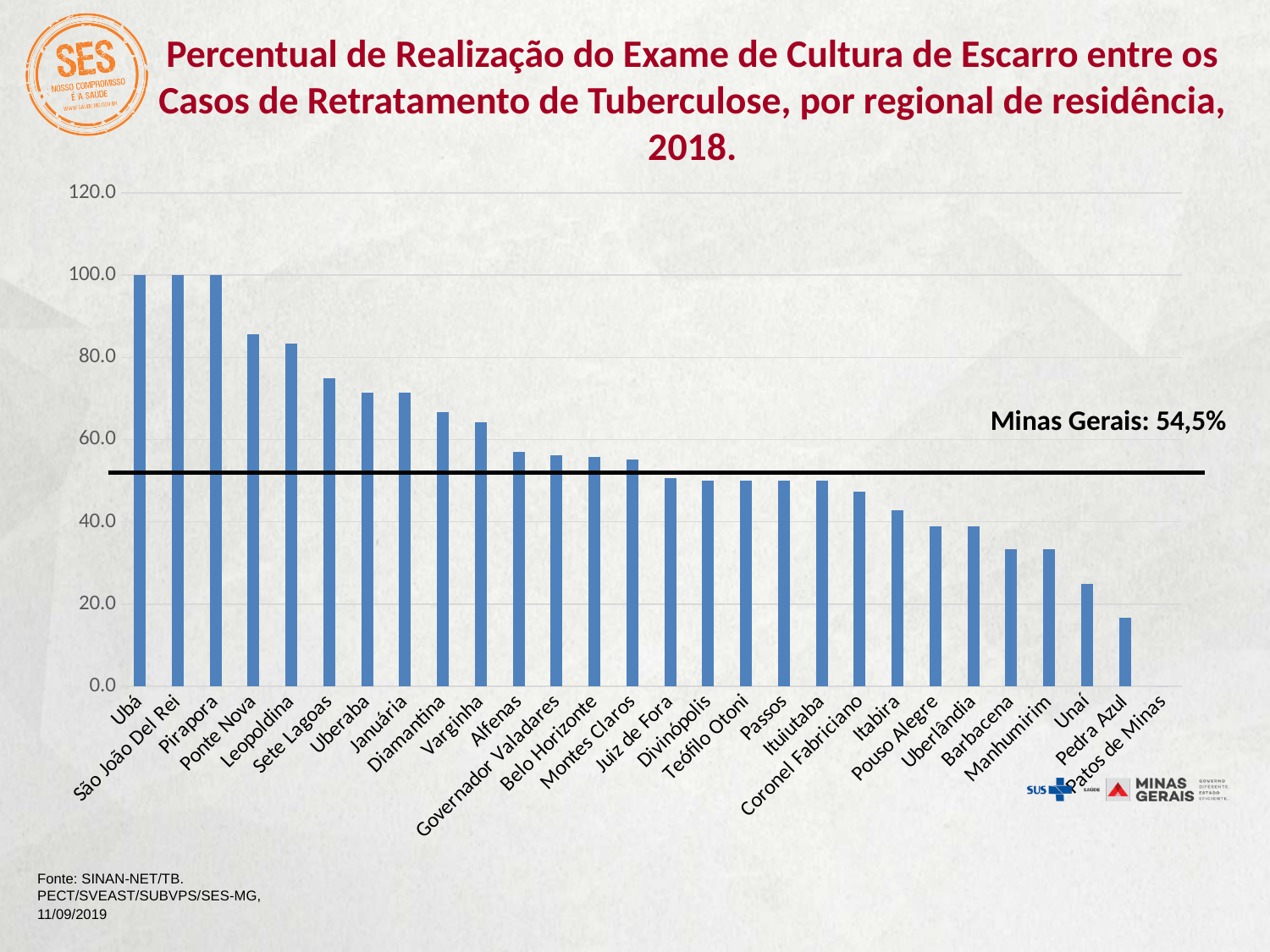
What is the value for Pirapora? 100.0 Is the value for Patos de Minas greater or less than 20.0? less What kind of chart is shown on the slide? bar chart Is the value for Itabira greater or less than 40.0? greater What is the value for Ubá? 100.0 Is the value for Pedra Azul greater or less than 40.0? less What value is given for Minas Gerais in the annotation on the chart? 54,5% Which has a larger value, Sete Lagoas or Varginha? Sete Lagoas Do the values rise or fall from left to right along the x axis? fall Which regional has the lowest value on the chart? Patos de Minas How many regionals (categories) are plotted on the chart? 28